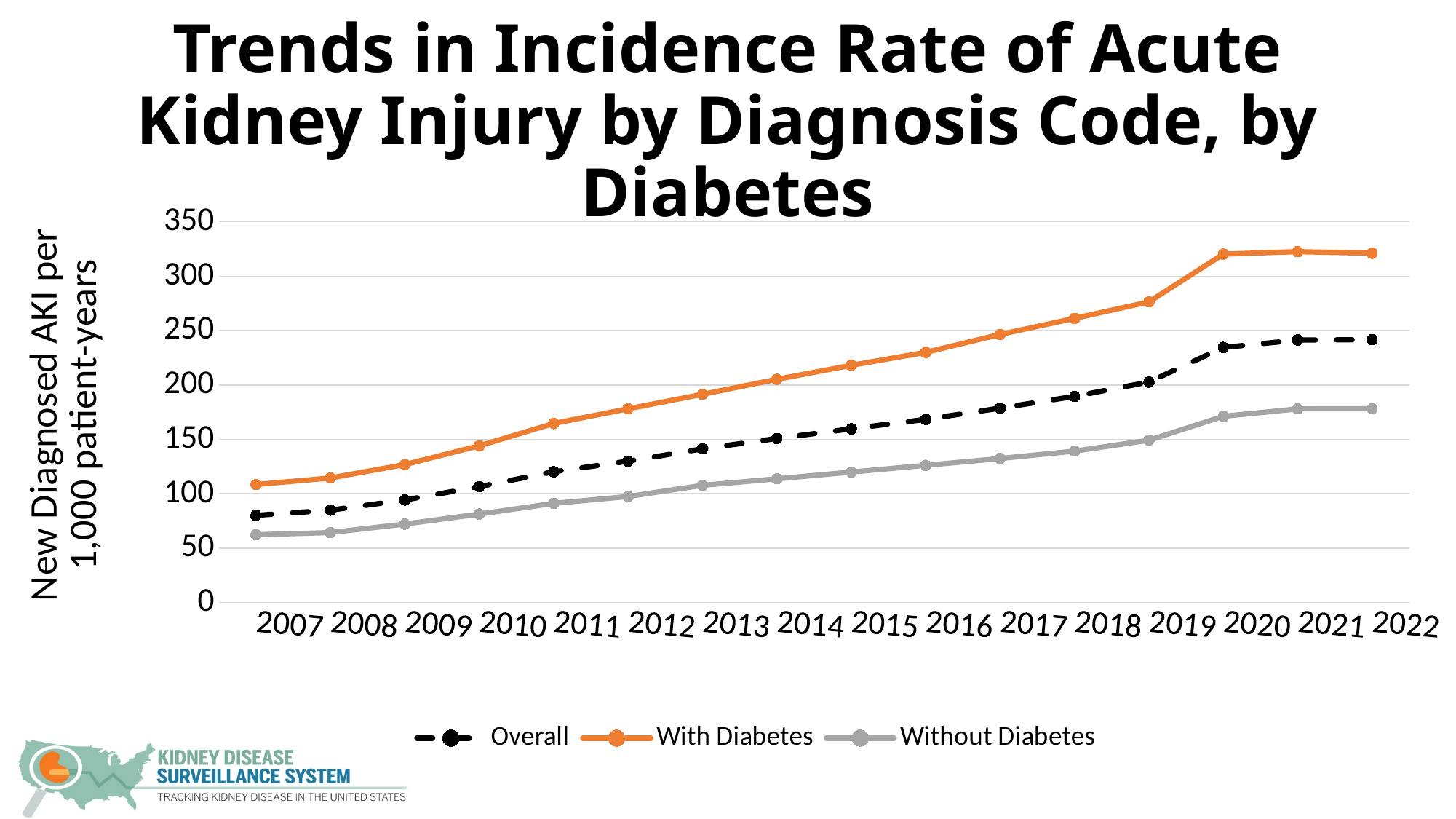
Is the value for With Diabetes in 2022 greater or less than 300? greater Is the value for Overall in 2007 greater or less than 100? less Which series has the highest value in 2022? With Diabetes Is the value for Without Diabetes in 2022 greater or less than 150? greater How many series does the legend list? 3 In 2015, which is larger: the value for With Diabetes or the value for Overall? With Diabetes Which series has the lowest value in 2007? Without Diabetes Do the values for the Overall series rise or fall from 2007 to 2022? rise What kind of chart is shown on the slide? line chart What is the label on the y axis? New Diagnosed AKI per 1,000 patient-years How many years are plotted along the x axis? 16